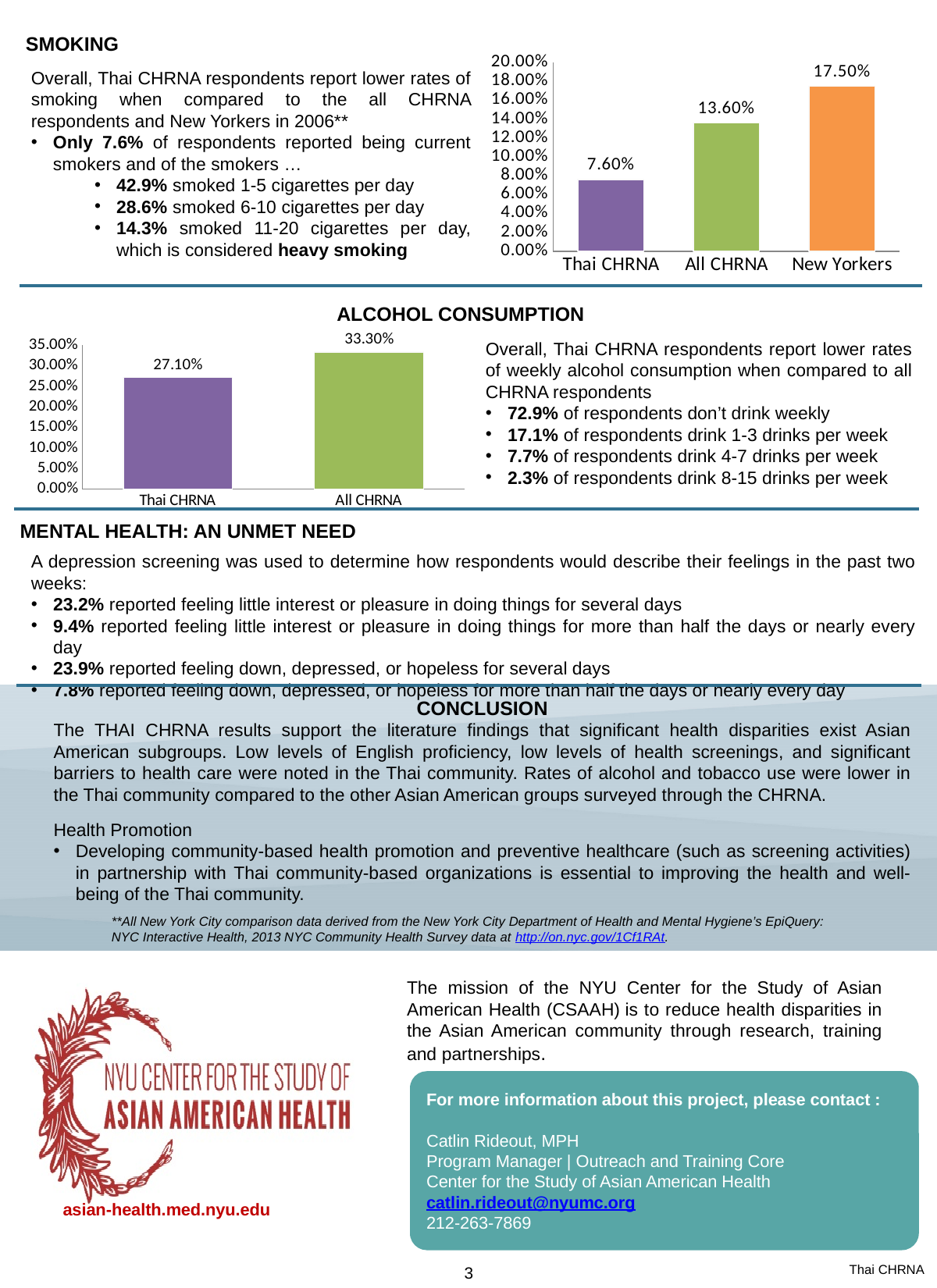
In the smoking chart (top right), what is the value for New Yorkers? 17.50% What type of chart is the alcohol consumption chart? Bar chart In the smoking chart (top right), which category has the highest value? New Yorkers In the alcohol consumption chart, which is larger, Thai CHRNA or All CHRNA? All CHRNA In the alcohol consumption chart, what is the difference between the All CHRNA and Thai CHRNA values? 6.20% In the smoking chart (top right), what is the value for Thai CHRNA? 7.60% In the alcohol consumption chart, what is the value for Thai CHRNA? 27.10% In the smoking chart (top right), what is the difference between the All CHRNA and Thai CHRNA values? 6.00% In the smoking chart (top right), how many categories are shown? 3 In the smoking chart (top right), is the value for All CHRNA greater or less than 12.00%? greater In the smoking chart (top right), which category has the lowest value? Thai CHRNA In the alcohol consumption chart, what is the value for All CHRNA? 33.30%